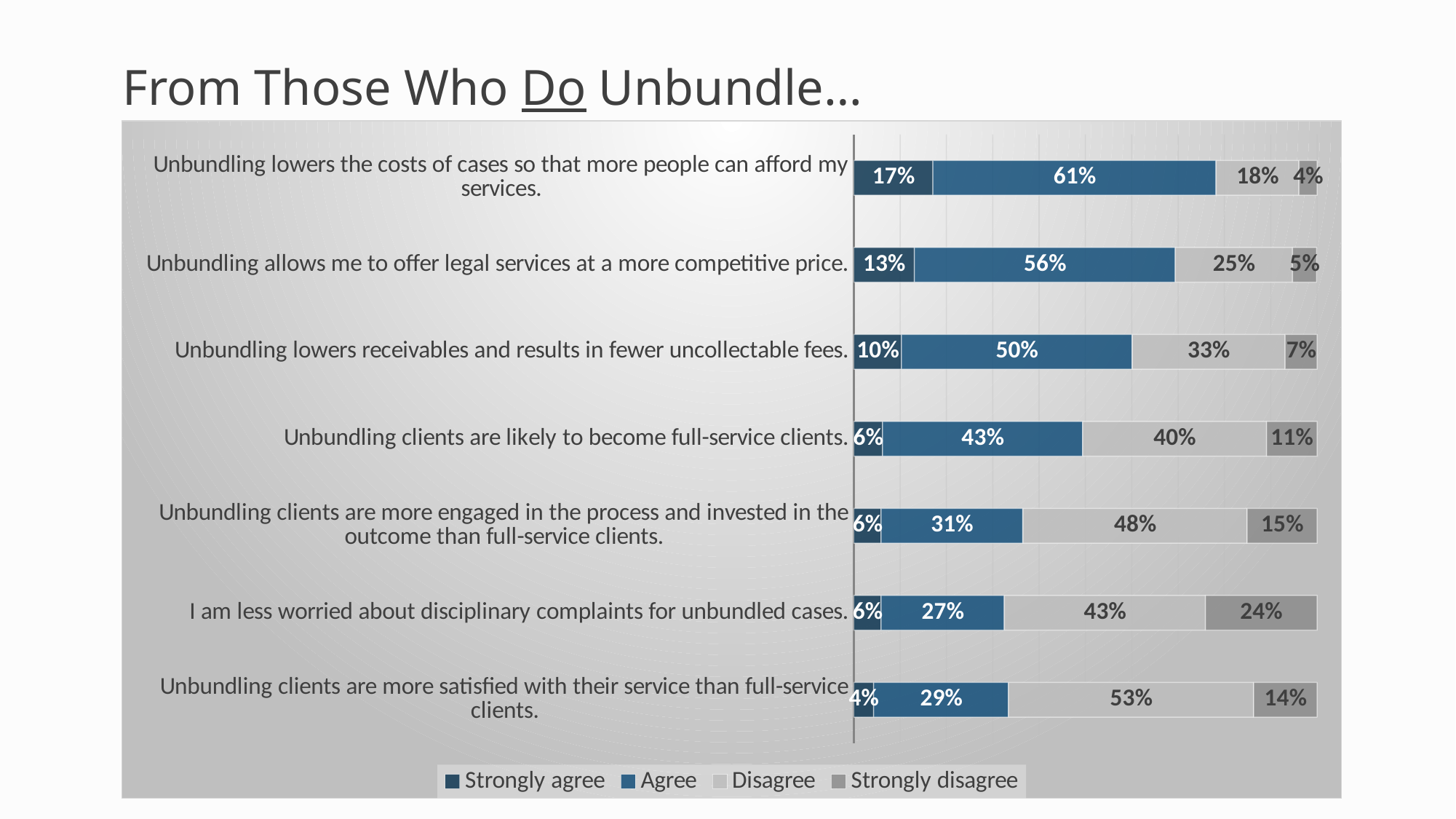
Which statement has the highest 'Agree' percentage? Unbundling lowers the costs of cases so that more people can afford my services. What is the difference between the 'Disagree' percentages for 'Unbundling clients are more satisfied with their service than full-service clients' and 'Unbundling lowers the costs of cases so that more people can afford my services'? 35% What percentage strongly disagree with the statement 'I am less worried about disciplinary complaints for unbundled cases'? 24% What percentage strongly agree that unbundling lowers the costs of cases so that more people can afford my services? 17% How many statements are shown in the chart? 7 What type of chart is shown on the slide? Stacked bar chart Which statement has the lowest 'Strongly agree' percentage? Unbundling clients are more satisfied with their service than full-service clients. What percentage disagree that unbundling clients are more satisfied with their service than full-service clients? 53% How many series does the legend list? 4 Which is larger: the 'Strongly disagree' percentage for 'Unbundling clients are more engaged in the process and invested in the outcome than full-service clients' or for 'Unbundling clients are likely to become full-service clients'? Unbundling clients are more engaged in the process and invested in the outcome than full-service clients. What percentage agree that unbundling allows me to offer legal services at a more competitive price? 56% What is the combined 'Strongly agree' and 'Agree' percentage for 'Unbundling lowers receivables and results in fewer uncollectable fees'? 60%